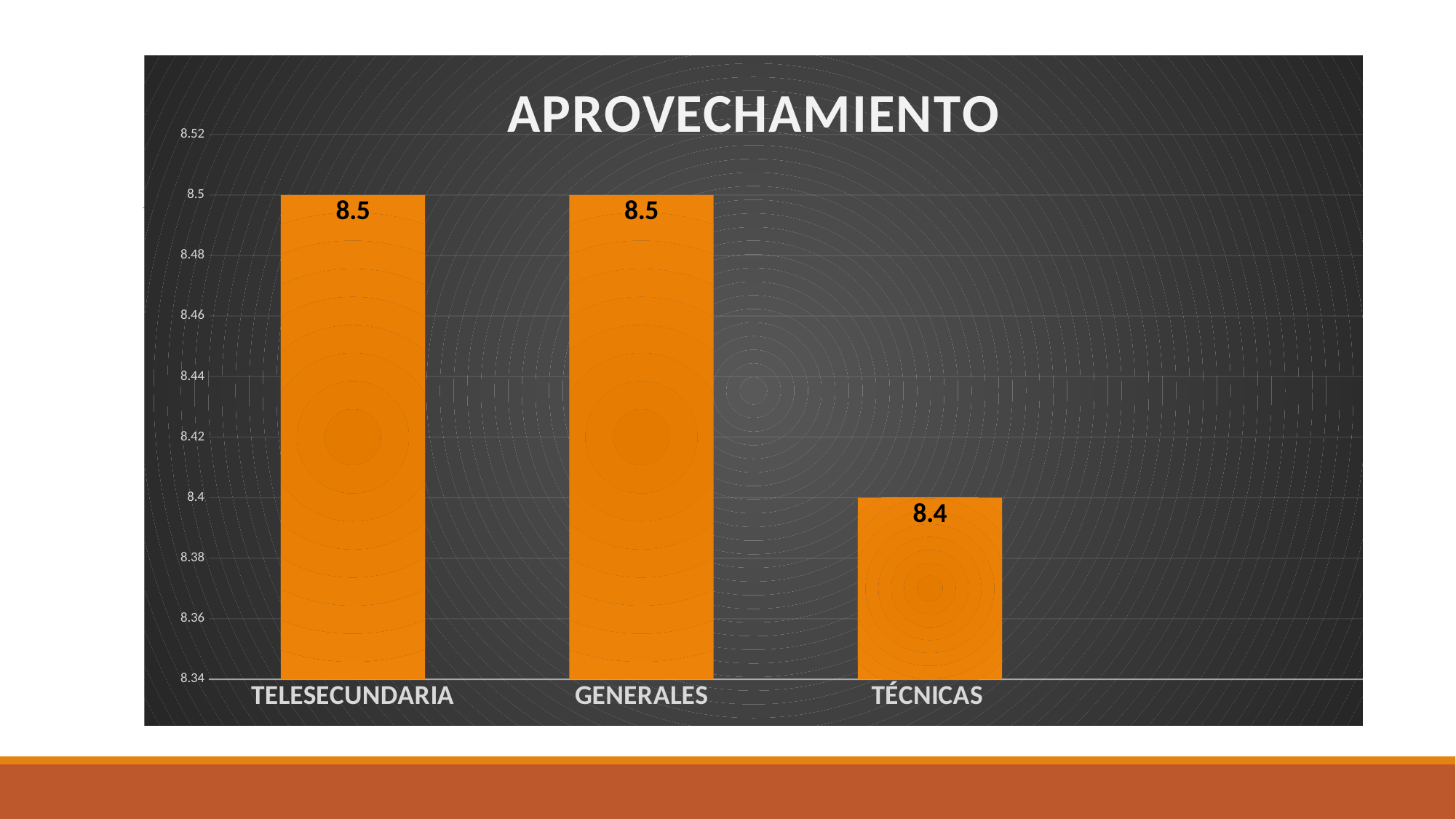
How many categories are shown on the x axis? 3 Is the value for GENERALES greater or less than 8.44? greater What kind of chart is shown on the slide? bar chart What colour are the bars in the chart? orange What is the value for TELESECUNDARIA? 8.5 What is the difference between the values for GENERALES and TÉCNICAS? 0.1 Is the value for TÉCNICAS greater or less than 8.46? less Which is larger, the value for TELESECUNDARIA or the value for TÉCNICAS? TELESECUNDARIA What is the value for TÉCNICAS? 8.4 What is the title of the chart? APROVECHAMIENTO What is the value for GENERALES? 8.5 Which category has the lowest value? TÉCNICAS